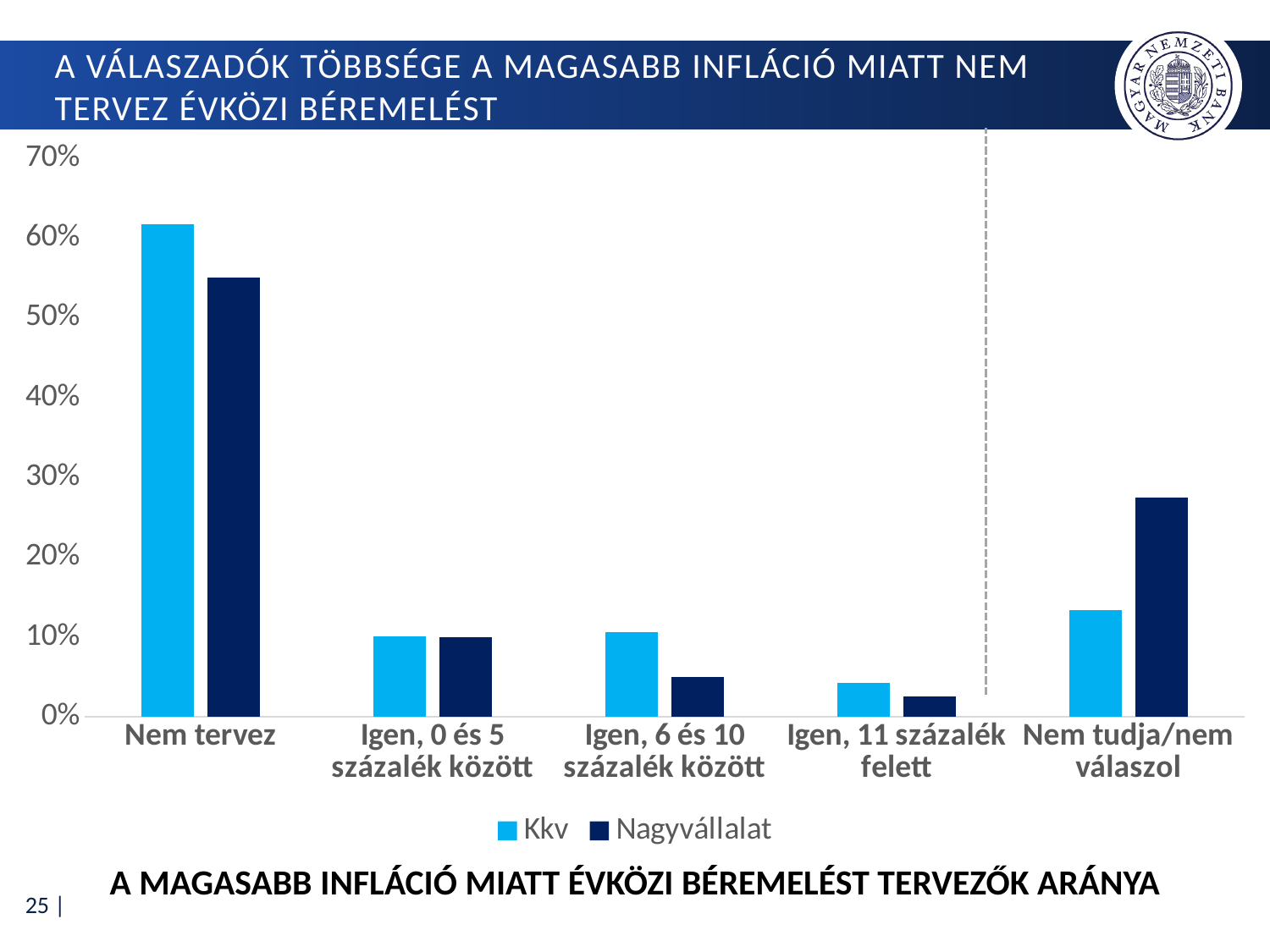
What kind of chart is shown on the slide? bar chart Is the Kkv value for Nem tervez greater or less than 60%? greater For the category Nem tudja/nem válaszol, which series has the larger value, Kkv or Nagyvállalat? Nagyvállalat What is the title printed below the chart? A MAGASABB INFLÁCIÓ MIATT ÉVKÖZI BÉREMELÉST TERVEZŐK ARÁNYA Which category has the highest value for the Kkv series? Nem tervez For the category Nem tervez, which series has the larger value, Kkv or Nagyvállalat? Kkv How many series does the legend list? 2 Is the Nagyvállalat value for Nem tudja/nem válaszol greater or less than 20%? greater Which category has the lowest value for the Kkv series? Igen, 11 százalék felett How many categories are shown on the x axis? 5 Is the Nagyvállalat value for Igen, 6 és 10 százalék között greater or less than 10%? less Which category has the lowest value for the Nagyvállalat series? Igen, 11 százalék felett